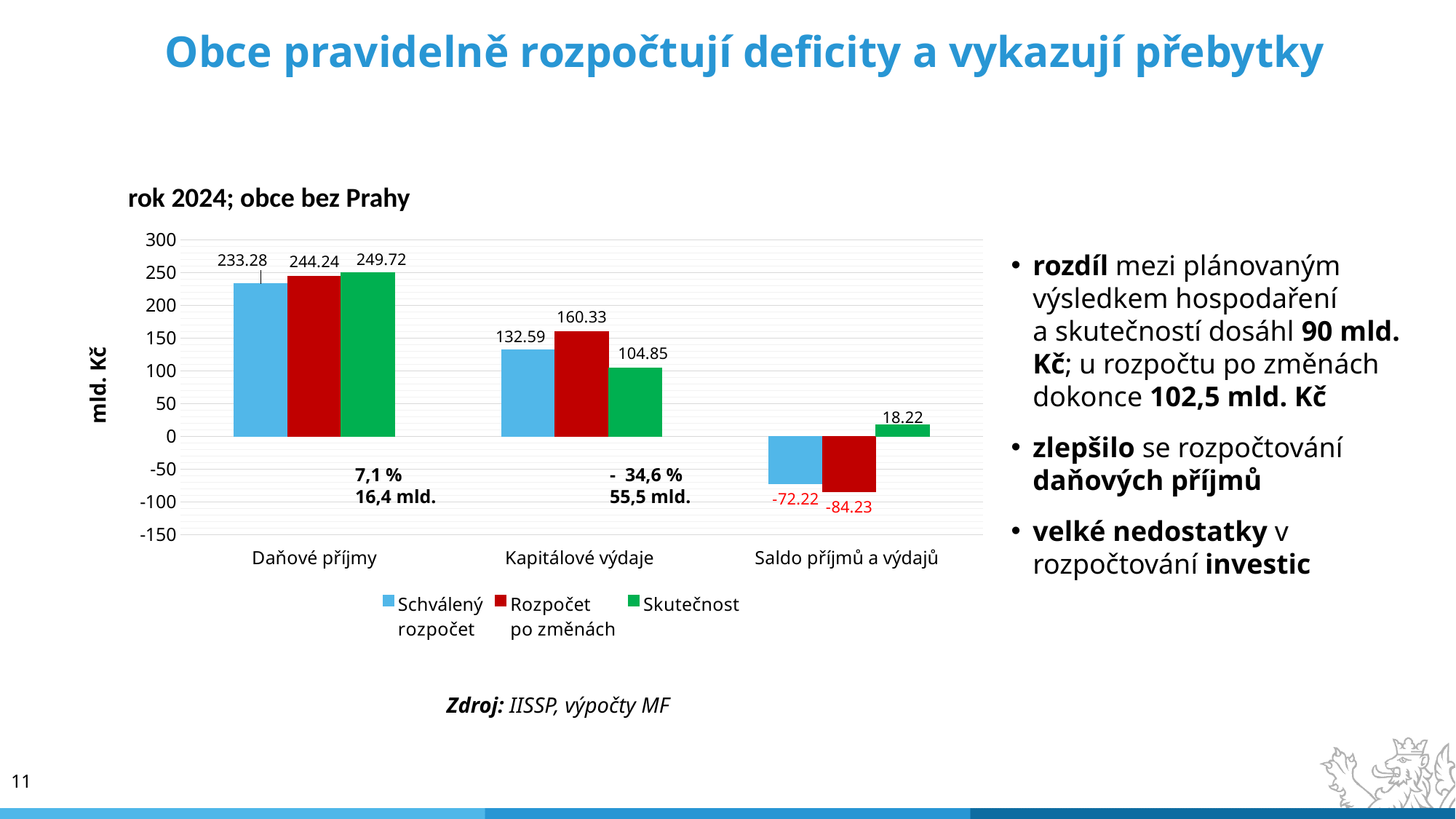
Which is larger for Daňové příjmy: Schválený rozpočet or Rozpočet po změnách? Rozpočet po změnách What kind of chart is shown on the slide? Bar chart Which series has the highest value for Kapitálové výdaje? Rozpočet po změnách What is the value of Skutečnost for Saldo příjmů a výdajů? 18.22 What unit is shown on the y axis label? mld. Kč What is the value of Rozpočet po změnách for Kapitálové výdaje? 160.33 How many series does the legend list? 3 What is the value of Skutečnost for Daňové příjmy? 249.72 What is the difference between Rozpočet po změnách and Skutečnost for Kapitálové výdaje? 55.48 How many categories are shown on the x axis? 3 Which series has the lowest value for Saldo příjmů a výdajů? Rozpočet po změnách What is the value of Schválený rozpočet for Saldo příjmů a výdajů? -72.22